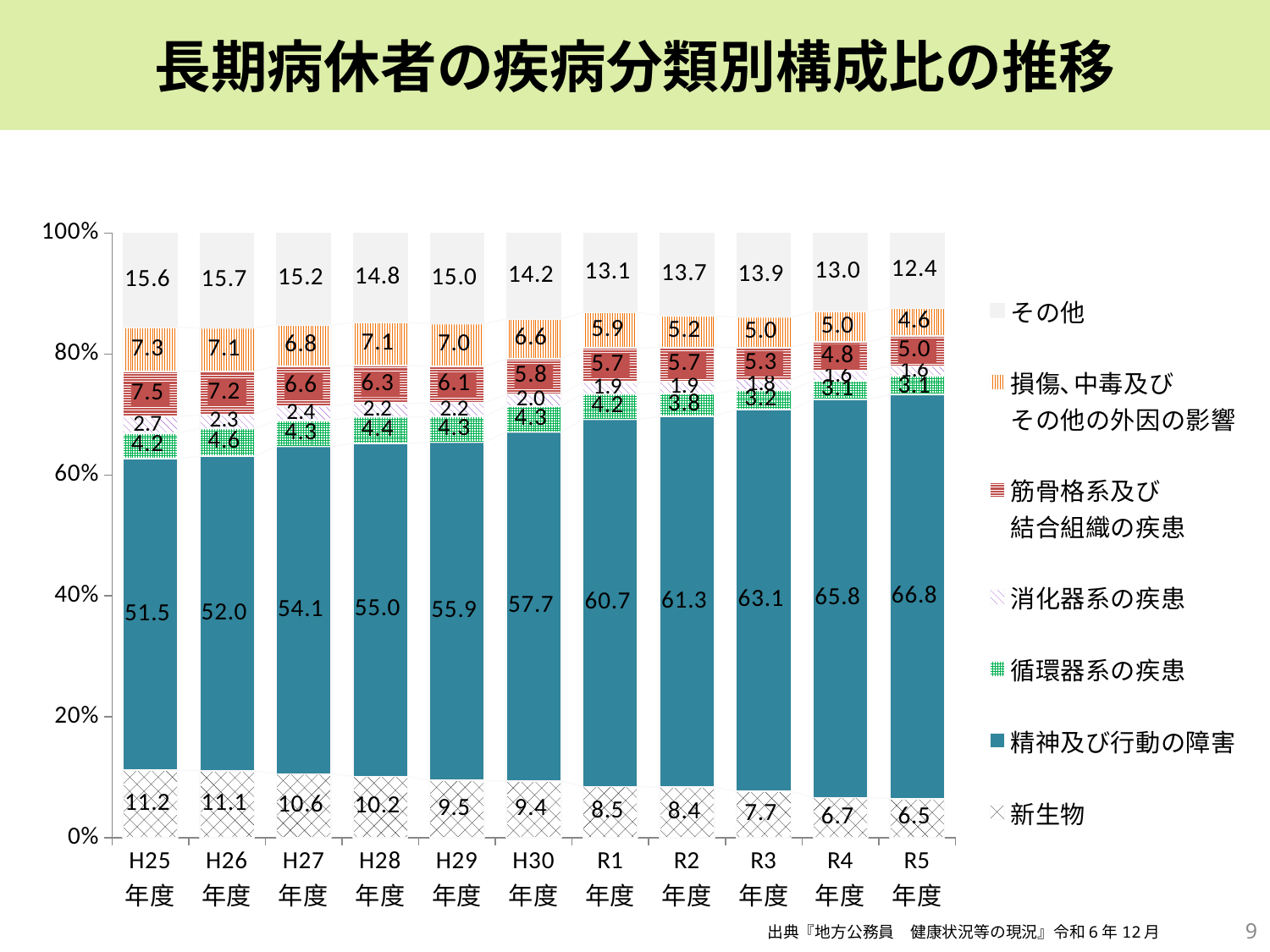
What is the value for 精神及び行動の障害 in R5年度? 66.8 Does the value for 精神及び行動の障害 rise or fall from H25年度 to R5年度? Rise Which is larger: the 損傷、中毒及びその他の外因の影響 value in H25年度 or in R5年度? H25年度 What is the difference between the 精神及び行動の障害 values in R5年度 and H25年度? 15.3 In which fiscal year is the value for 精神及び行動の障害 the highest? R5年度 In which fiscal year is the value for 新生物 the lowest? R5年度 How many fiscal years (categories) are shown on the x axis? 11 What is the value for 新生物 in H25年度? 11.2 What is the value for その他 in H30年度? 14.2 How many series does the legend list? 7 What kind of chart is shown on the slide? Stacked bar chart What is the title of the chart? 長期病休者の疾病分類別構成比の推移